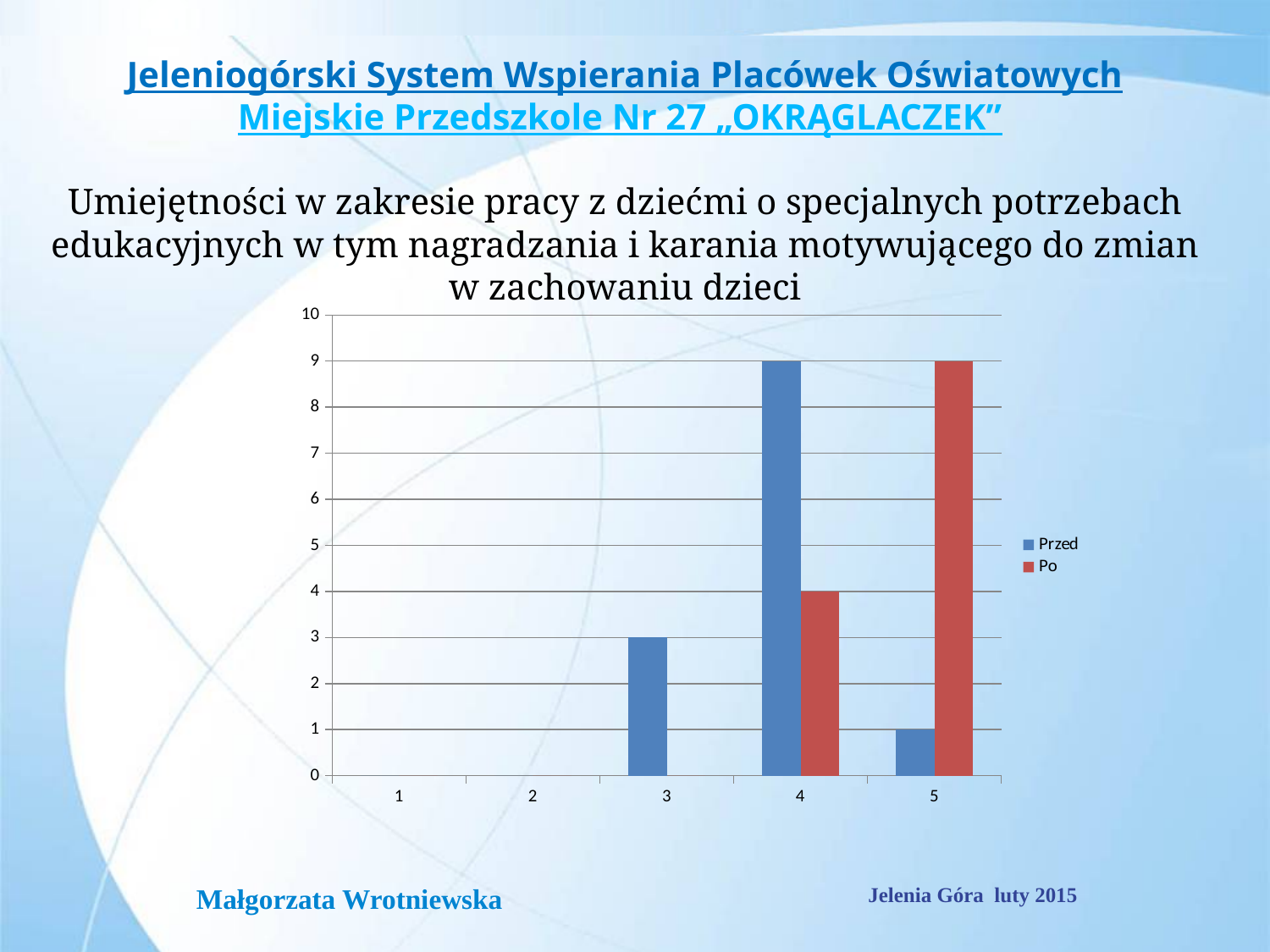
What kind of chart is shown on the slide? bar chart What are the names of the series in the legend? Przed, Po What is the difference between the Przed and Po values for category 4? 5 For which category is the Po series highest? 5 For which category is the Przed series highest? 4 What is the value of the Przed series for category 3? 3 How many categories are shown on the x axis? 5 What is the value of the Przed series for category 5? 1 What is the value of the Po series for category 4? 4 How many series does the legend list? 2 What is the value of the Po series for category 5? 9 What is the value of the Przed series for category 4? 9